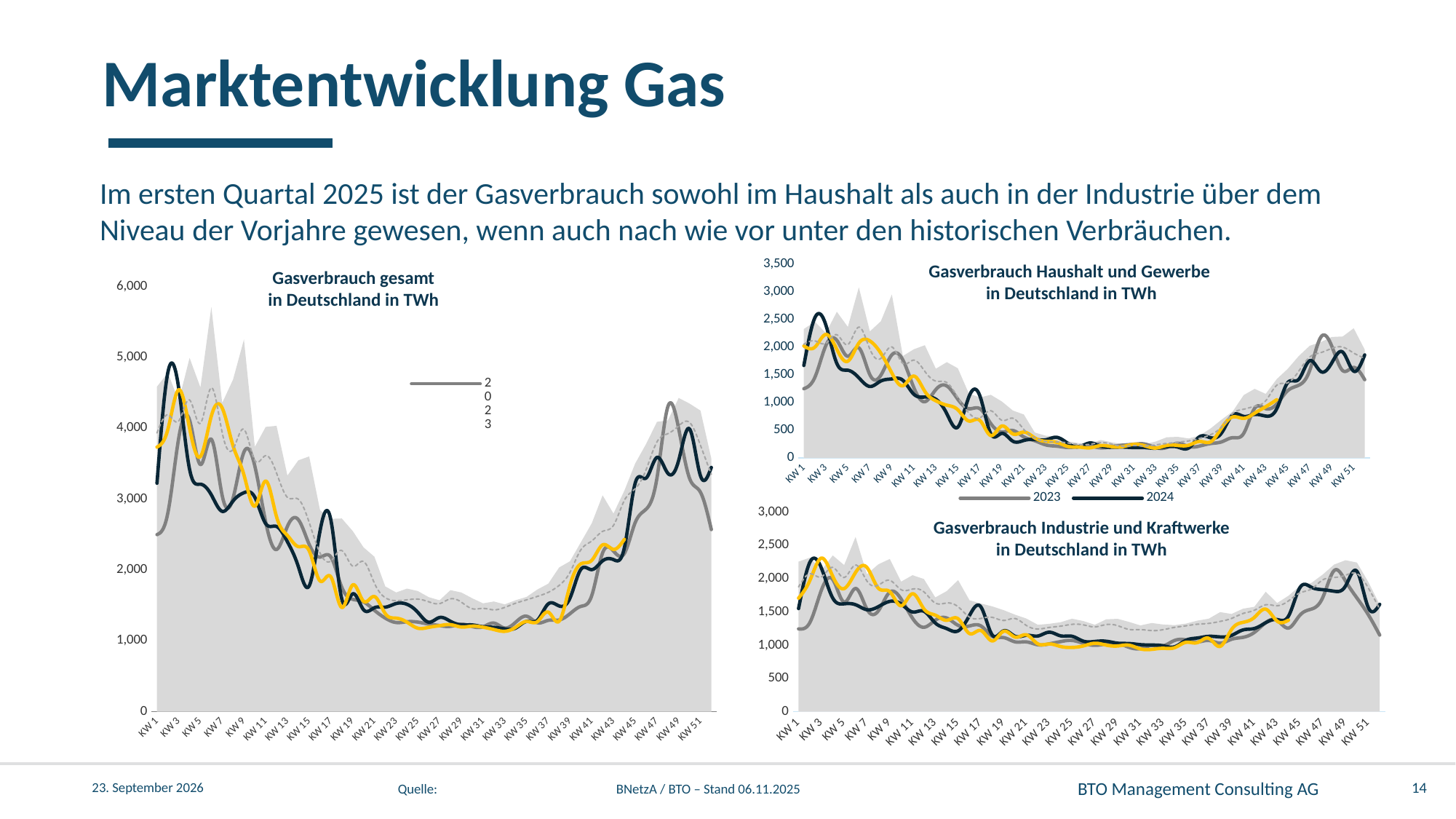
In the 'Gasverbrauch Industrie und Kraftwerke' chart, is the 2024 value at KW 49 greater or less than 1,500? greater How many series does the legend of the 'Gasverbrauch Haushalt und Gewerbe' chart list? 2 In the 'Gasverbrauch Industrie und Kraftwerke' chart, is the 2023 value at KW 1 greater or less than 1,500? less In the 'Gasverbrauch Haushalt und Gewerbe' chart, do the 2024 values rise or fall between KW 35 and KW 47? rise In the 'Gasverbrauch gesamt' chart, is the 2024 value at KW 3 greater or less than 4,000? greater What is the highest tick on the y axis of the 'Gasverbrauch gesamt in Deutschland in TWh' chart? 6,000 Which two years are named in the legend of the 'Gasverbrauch Haushalt und Gewerbe' chart? 2023 and 2024 What kind of chart is 'Gasverbrauch gesamt in Deutschland in TWh'? combination area and line chart In the 'Gasverbrauch gesamt' chart, do the 2024 values rise or fall between KW 5 and KW 25? fall